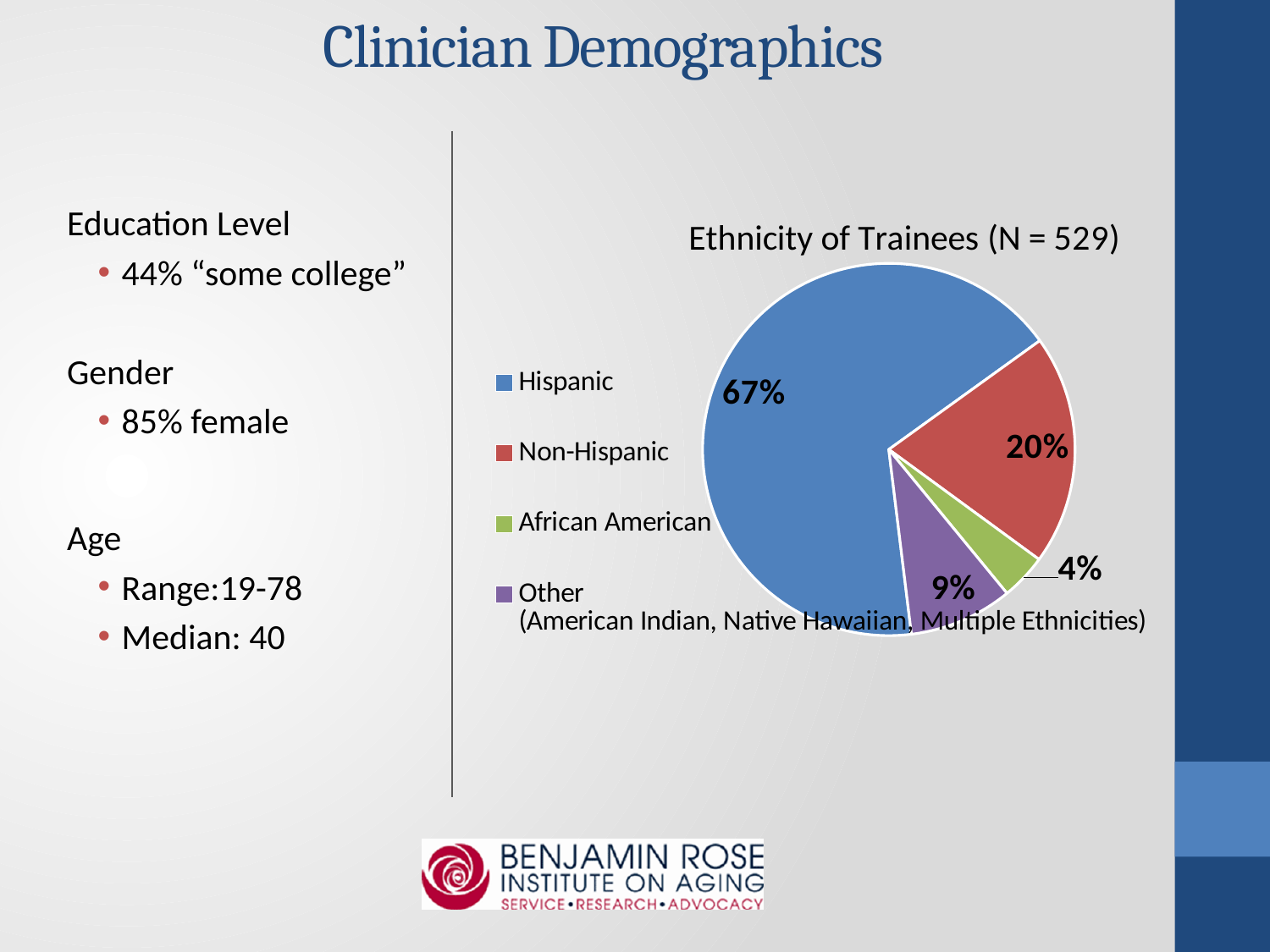
Which ethnicities does the legend list under the Other category? American Indian, Native Hawaiian, Multiple Ethnicities Which ethnicity category has the smallest share of trainees? African American Which ethnicity category has the largest share of trainees? Hispanic What percentage of trainees are Hispanic? 67% Which is larger, the Other slice or the African American slice? Other What percentage of trainees are Non-Hispanic? 20% What percentage of trainees fall into the Other category? 9% What type of chart is shown on the slide? Pie chart How many categories does the pie chart show? 4 What is the title of the chart? Ethnicity of Trainees (N = 529) What is the difference in percentage points between the Hispanic and Non-Hispanic slices? 47 What percentage of trainees are African American? 4%